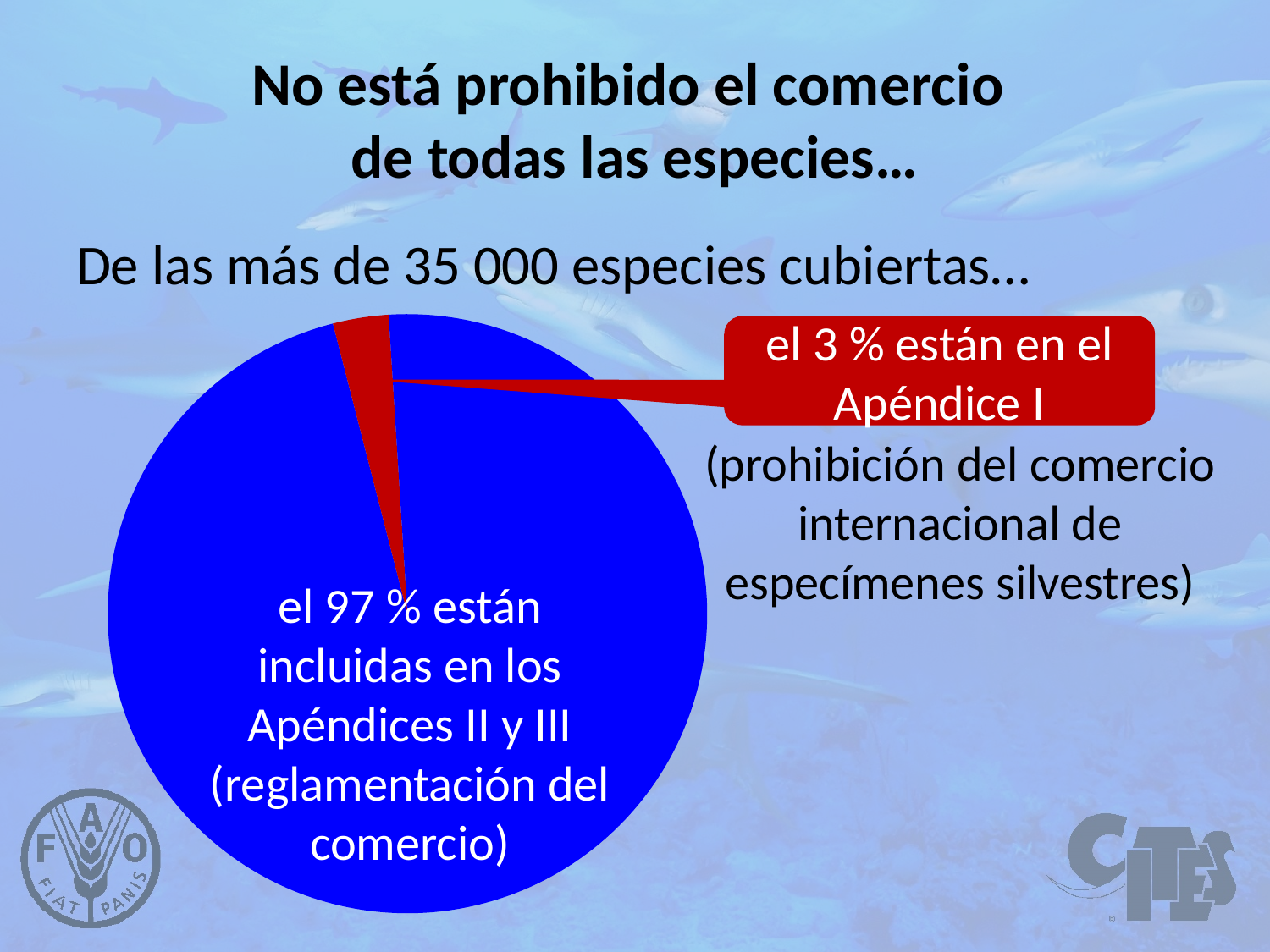
Which slice of the pie chart is the largest? Apéndices II y III Which is larger in the pie chart: the Apéndice I slice or the Apéndices II y III slice? Apéndices II y III How many slices does the pie chart have? 2 What colour is the Apéndice I slice in the pie chart? red What colour is the Apéndices II y III slice in the pie chart? blue Which slice of the pie chart is the smallest? Apéndice I What share of the species covered are included in Apéndices II y III according to the pie chart? 97 % What is the difference in percentage points between the Apéndices II y III slice and the Apéndice I slice? 94 Is the share for Apéndices II y III in the pie chart greater or less than 50 %? greater What is the total of the two slices shown in the pie chart? 100 % What kind of chart is shown on the slide? pie chart What share of the species covered are in Apéndice I according to the pie chart? 3 %